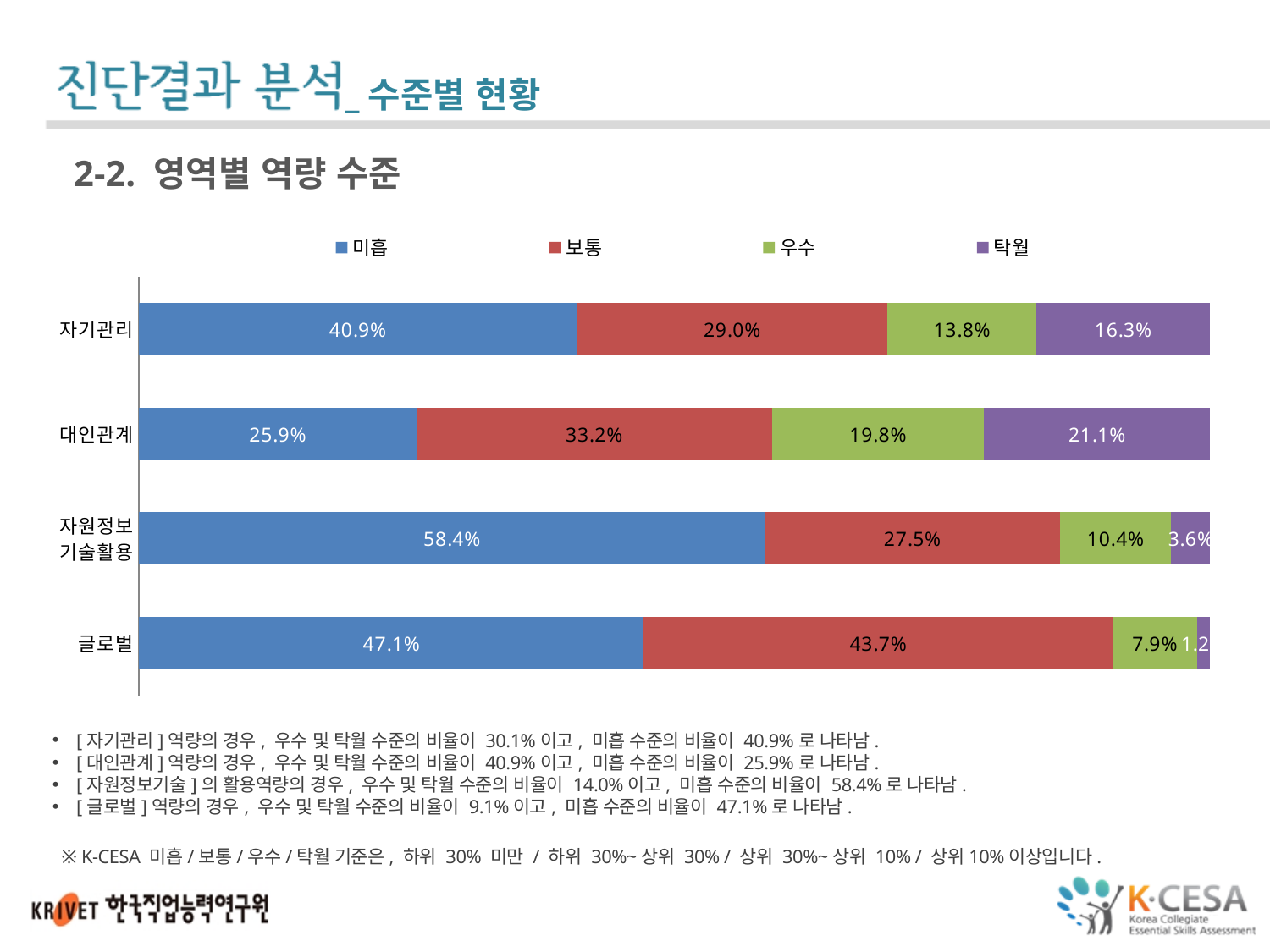
How many series does the legend list? 4 Which category has the lowest 미흡 value? 대인관계 What type of chart is shown on the slide? stacked bar chart How many categories are plotted on the chart? 4 What is the 미흡 value for 자기관리? 40.9% What is the 탁월 value for 자원정보기술활용? 3.6% Which category has the highest 미흡 value? 자원정보기술활용 What is the 우수 value for 글로벌? 7.9% Which is larger, the 탁월 value for 대인관계 or the 탁월 value for 자기관리? 대인관계 What is the 보통 value for 대인관계? 33.2% Which legend entry is shown in green? 우수 What is the difference between the 보통 values for 글로벌 and 자기관리? 14.7%